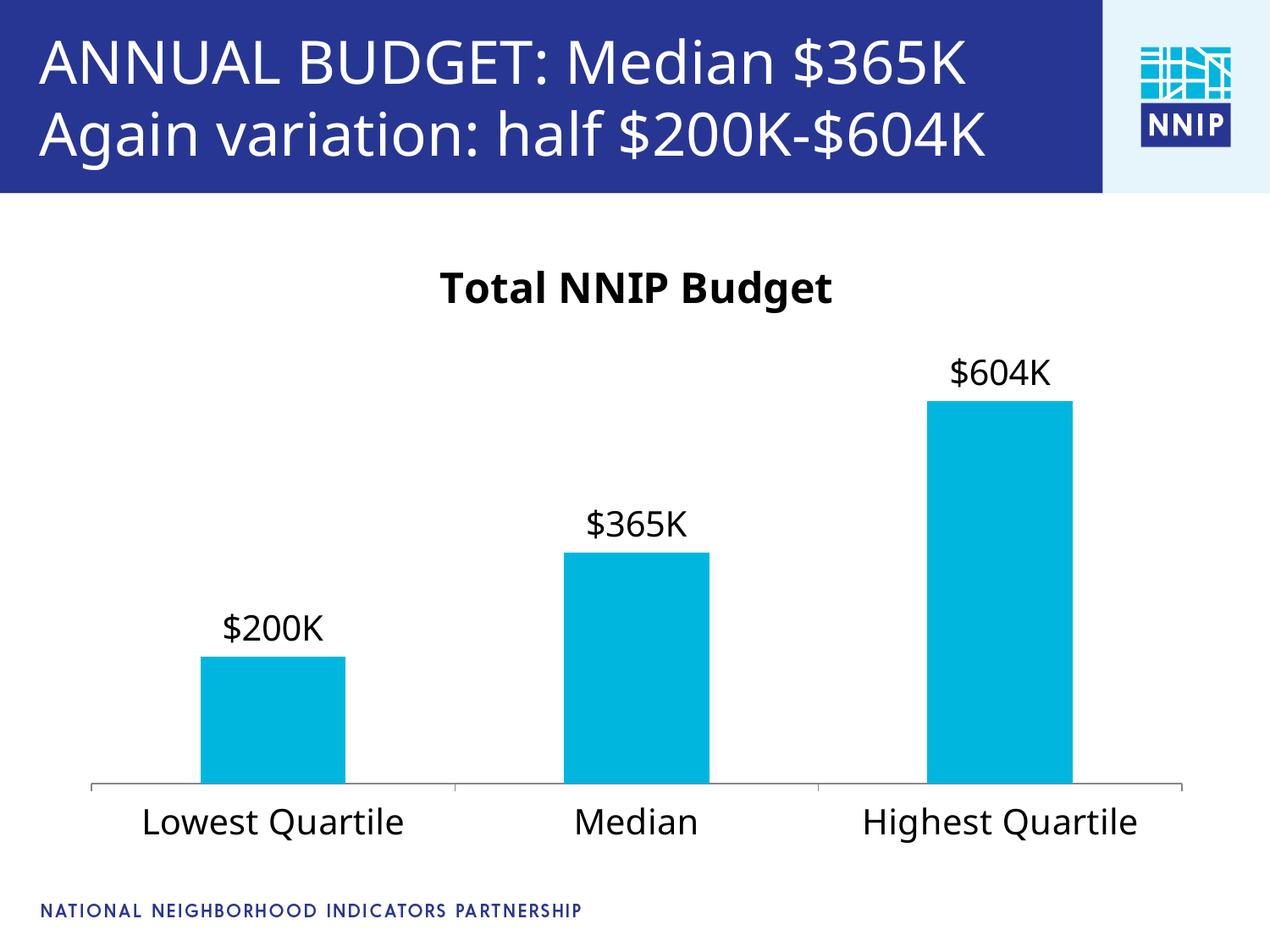
What is the value for Lowest Quartile? $200K What is the value for Median? $365K Which category has the lowest value? Lowest Quartile What is the value for Highest Quartile? $604K Which category has the highest value? Highest Quartile What is the difference between the Highest Quartile and the Lowest Quartile values? $404K How many categories are shown on the x axis? 3 Which is larger, the value for Median or the value for Highest Quartile? Highest Quartile What is the difference between the Median and the Lowest Quartile values? $165K What kind of chart is this? Bar chart What is the title of the chart? Total NNIP Budget Do the values rise or fall from left to right along the x axis? Rise